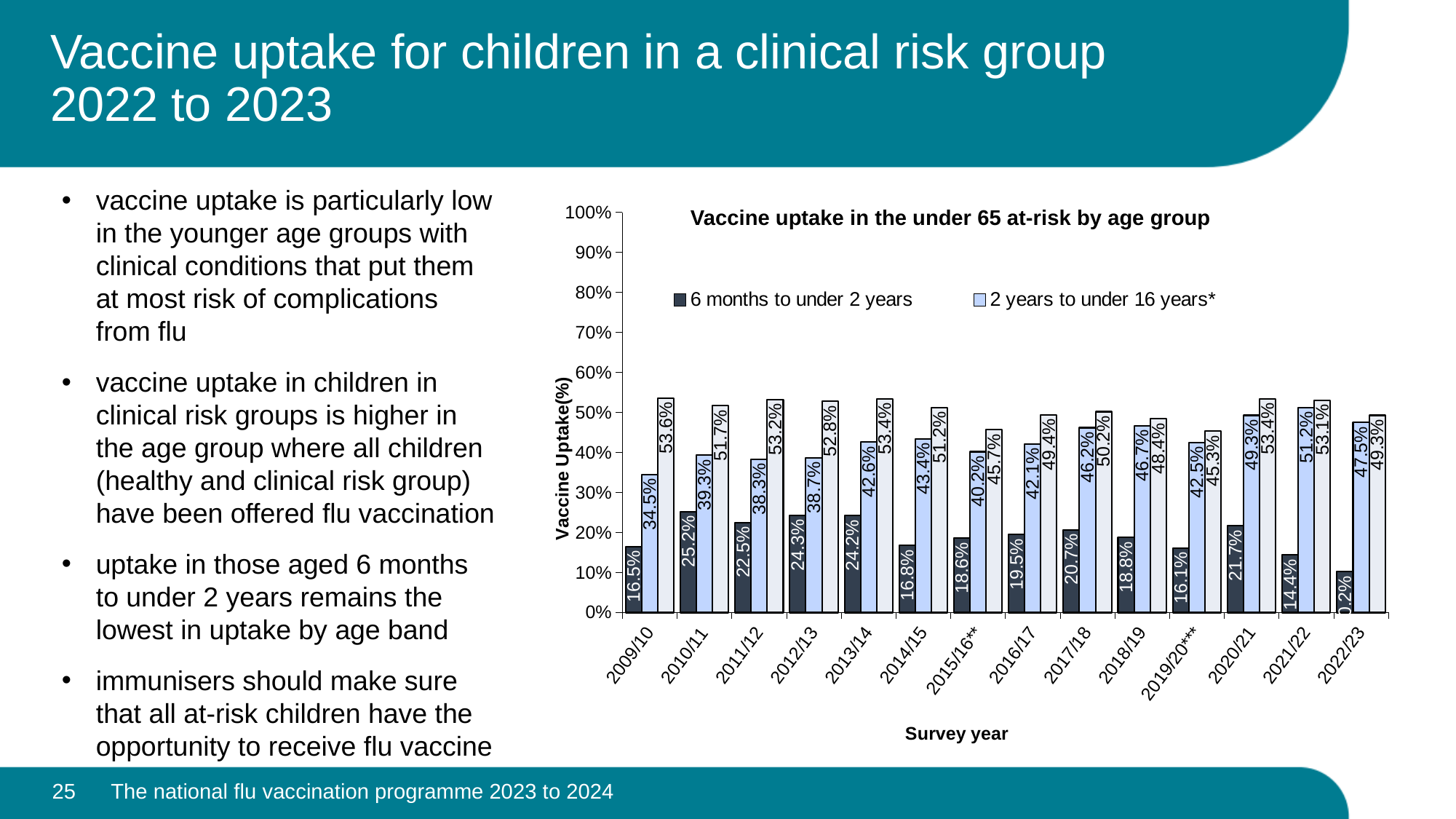
What is the vaccine uptake for 2 years to under 16 years* in 2009/10? 34.5% Is the uptake for 6 months to under 2 years higher in 2012/13 or in 2014/15? 2012/13 Which survey year has the lowest uptake for 6 months to under 2 years? 2022/23 How many survey years are shown on the x axis? 14 What is the difference between the 2 years to under 16 years* uptake and the 6 months to under 2 years uptake in 2017/18? 25.5% Which survey year has the lowest uptake for 2 years to under 16 years*? 2009/10 How many series does the legend list? 2 Which survey year has the highest uptake for 6 months to under 2 years? 2010/11 What is the vaccine uptake for 6 months to under 2 years in 2019/20***? 16.1% Is the uptake for 2 years to under 16 years* in 2020/21 greater or less than 40%? greater What is the vaccine uptake for 2 years to under 16 years* in 2021/22? 51.2% What is the vaccine uptake for 6 months to under 2 years in 2010/11? 25.2%